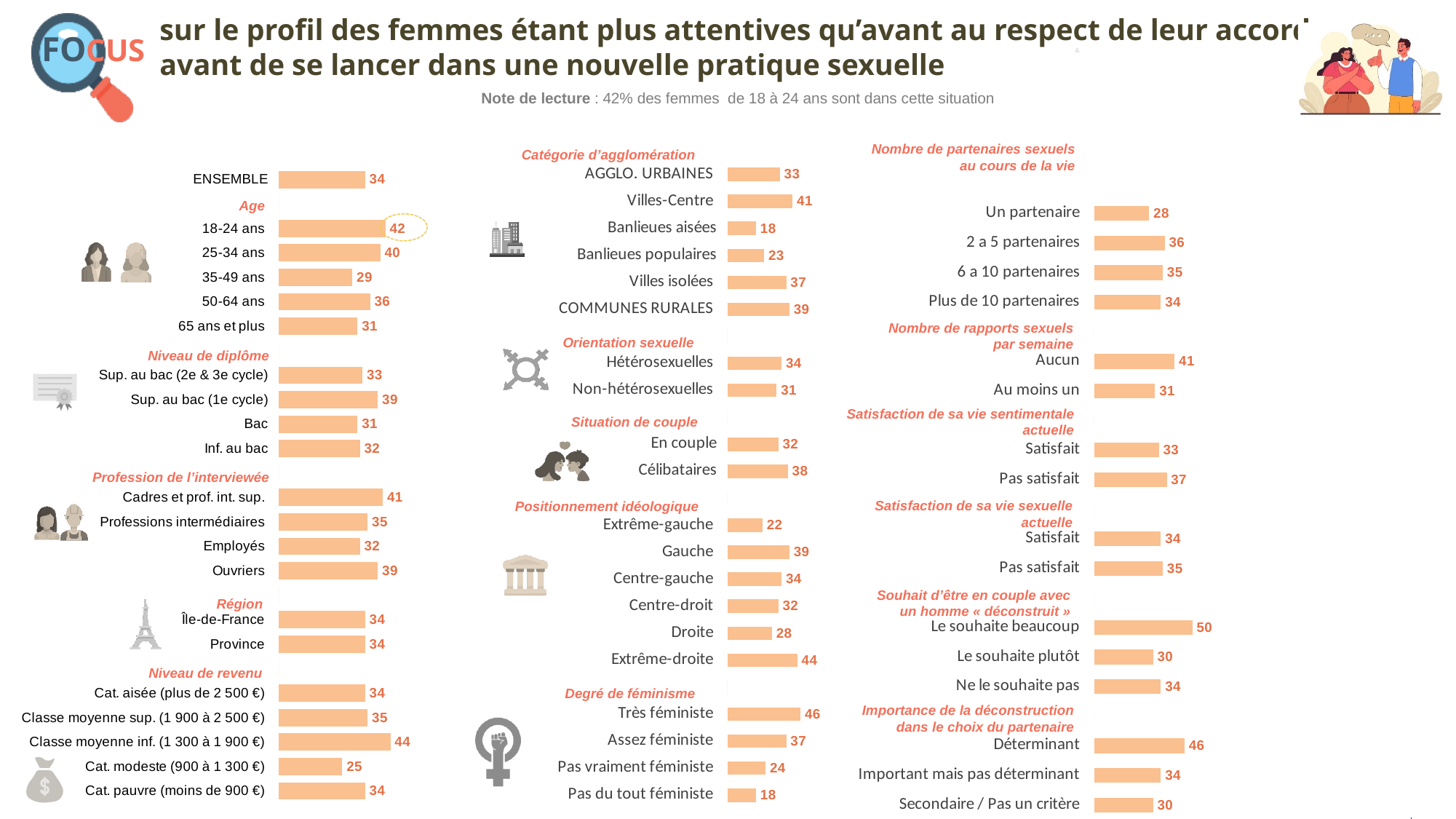
In the Catégorie d'agglomération chart, which category has the lowest value? Banlieues aisées In the Positionnement idéologique chart, which is larger: the value for Extrême-droite or for Extrême-gauche? Extrême-droite In the Degré de féminisme chart, do the values rise or fall from Très féministe to Pas du tout féministe? Fall In the chart at the top left, what is the value for ENSEMBLE? 34 What kind of chart is used throughout this slide? Bar chart In the chart titled 'Nombre de partenaires sexuels au cours de la vie', which category has the highest value? 2 a 5 partenaires In the Niveau de revenu chart, what is the difference between the values for 'Cat. pauvre (moins de 900 €)' and 'Cat. modeste (900 à 1 300 €)'? 9 In the Degré de féminisme chart, how many categories are shown? 4 In the Situation de couple chart, what is the difference between the values for Célibataires and En couple? 6 In the Niveau de revenu chart, which category has the highest value? Classe moyenne inf. (1 300 à 1 900 €) In the Age chart, what is the value for 18-24 ans? 42 In the chart titled 'Souhait d'être en couple avec un homme « déconstruit »', what is the value for 'Le souhaite beaucoup'? 50